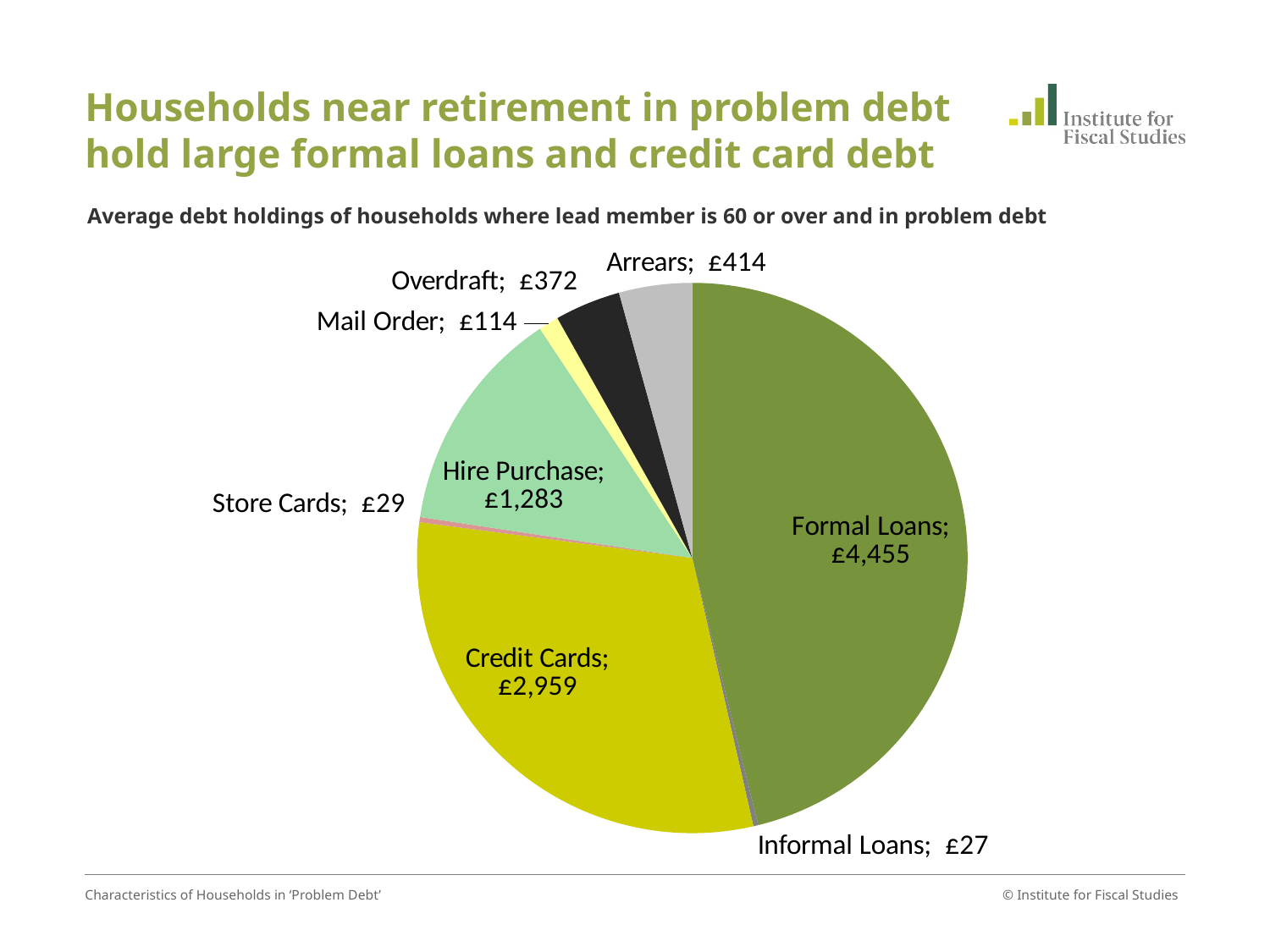
What is the total of all the debt values shown in the pie chart? £9,653 What is the value shown for Mail Order? £114 How many debt categories are shown in the pie chart? 8 What kind of chart is shown on the slide? Pie chart How much larger is the Formal Loans value than the Credit Cards value? £1,496 What is the subtitle describing the data in the chart? Average debt holdings of households where lead member is 60 or over and in problem debt Which debt category has the largest slice of the pie? Formal Loans Which is larger, the value for Arrears or the value for Overdraft? Arrears What is the difference between the Arrears value and the Overdraft value? £42 Which debt category has the smallest value? Informal Loans What is the average debt holding for Formal Loans? £4,455 What is the value shown for Hire Purchase? £1,283